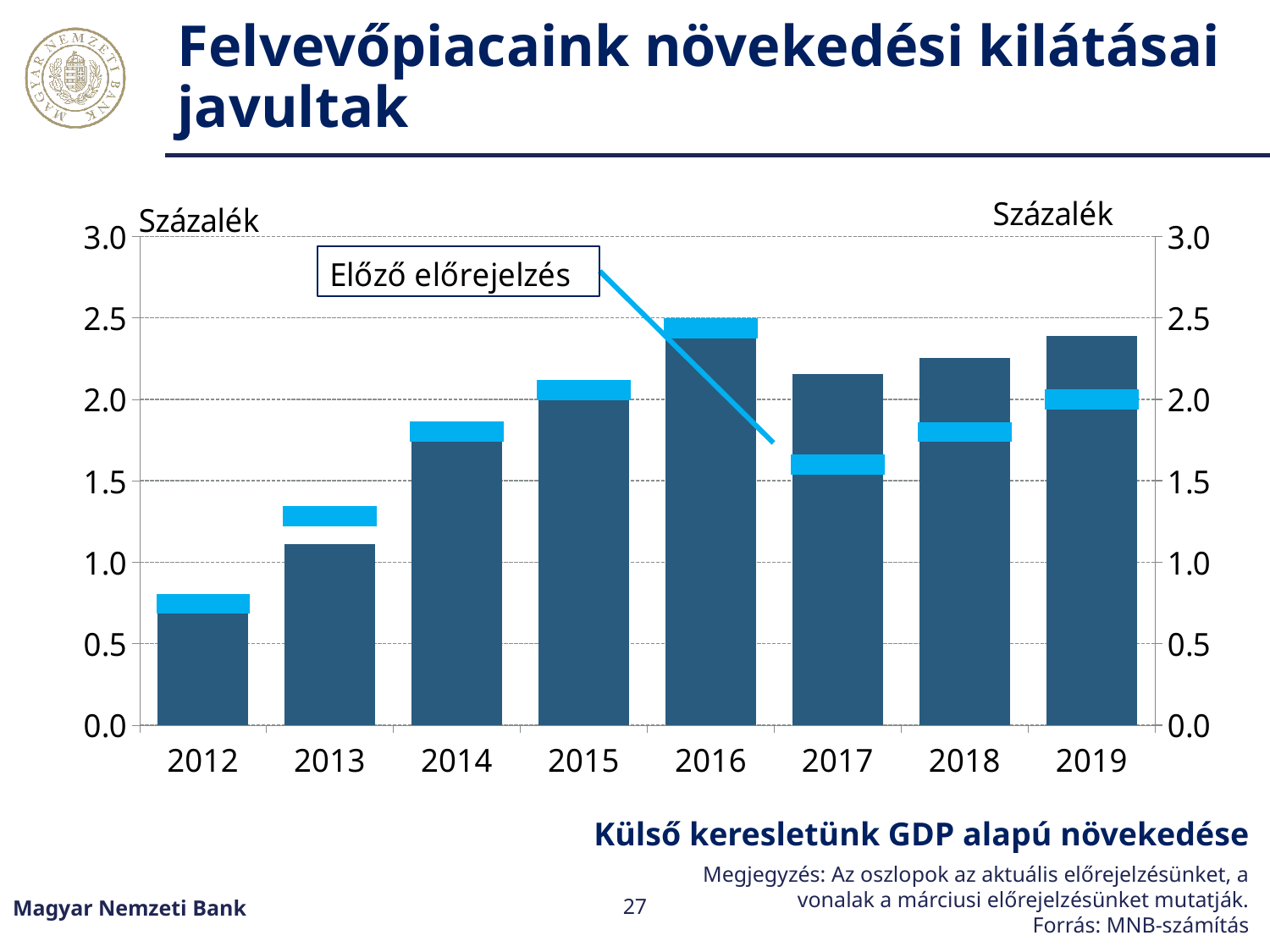
Which bar is taller, 2013 or 2014? 2014 Is the value of the bar for 2013 greater or less than 1.0? greater What kind of chart is shown on the slide? bar chart How many years are shown on the x axis of the chart? 8 Is the value of the bar for 2014 greater or less than 1.5? greater What label is shown in the annotation box pointing to the light blue markers? Előző előrejelzés Is the value of the bar for 2017 greater or less than 2.0? greater Which year has the lowest bar in the chart? 2012 Do the bars rise or fall from 2012 to 2016? rise Which bar is taller, 2016 or 2017? 2016